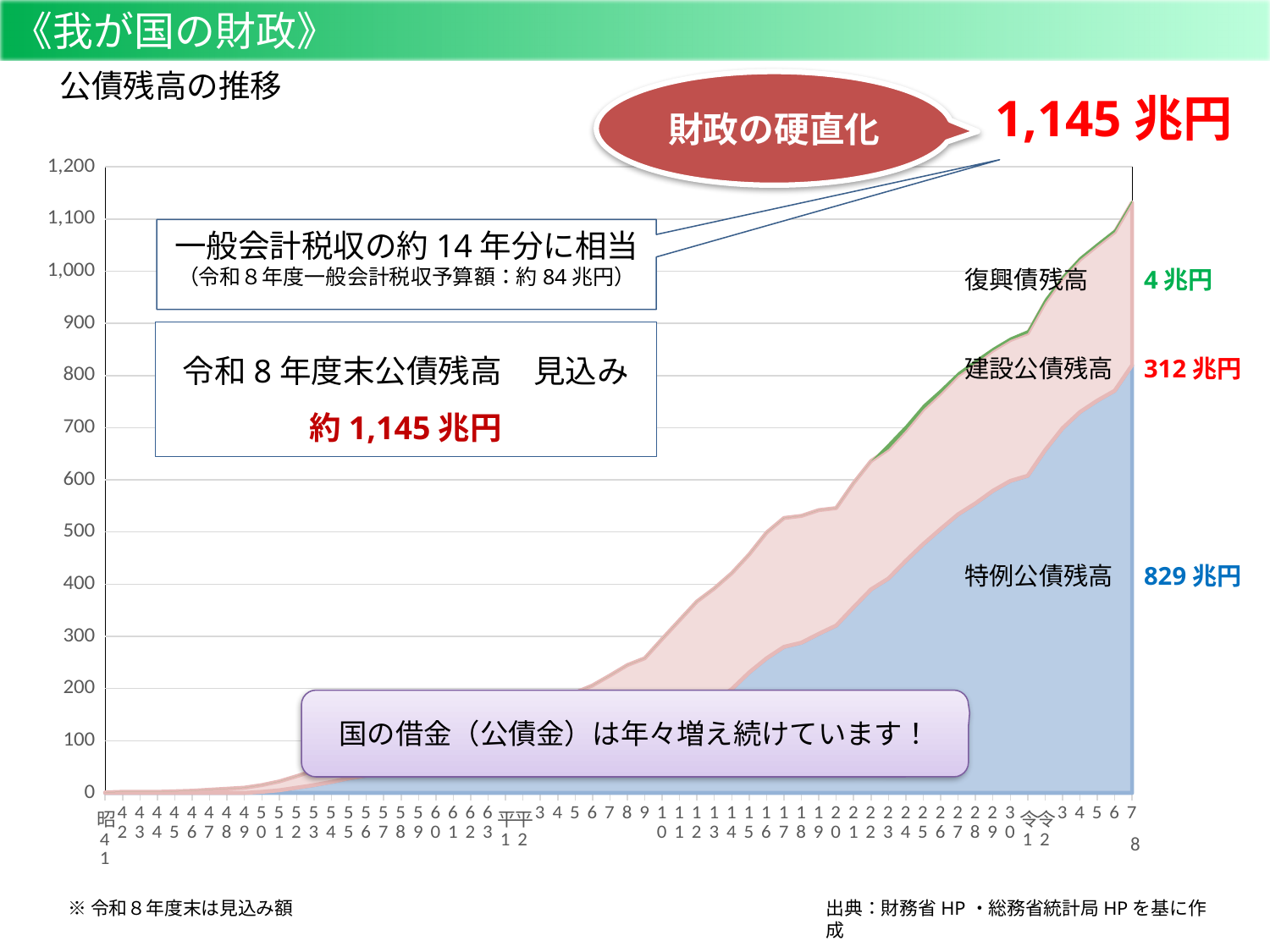
What is the value shown for 建設公債残高 at the end of 令和8年度? 312兆円 What is the total 公債残高 expected at the end of 令和8年度 according to the slide? 約1,145兆円 Which of the three bond categories has the largest outstanding balance at the end of 令和8年度? 特例公債残高 What is the highest value shown on the vertical axis of the chart? 1,200 Does the total 公債残高 rise or fall over time along the x axis? Rises What is the value shown for 復興債残高 at the end of 令和8年度? 4兆円 Which of the three bond categories has the smallest outstanding balance at the end of 令和8年度? 復興債残高 Which is larger at the end of 令和8年度, 建設公債残高 or 復興債残高? 建設公債残高 What is the value shown for 特例公債残高 at the end of 令和8年度? 829兆円 What kind of chart is used to show 公債残高の推移? Stacked area chart How many categories of bond balance are stacked in the chart? 3 What is the difference between 特例公債残高 and 建設公債残高 at the end of 令和8年度? 517兆円